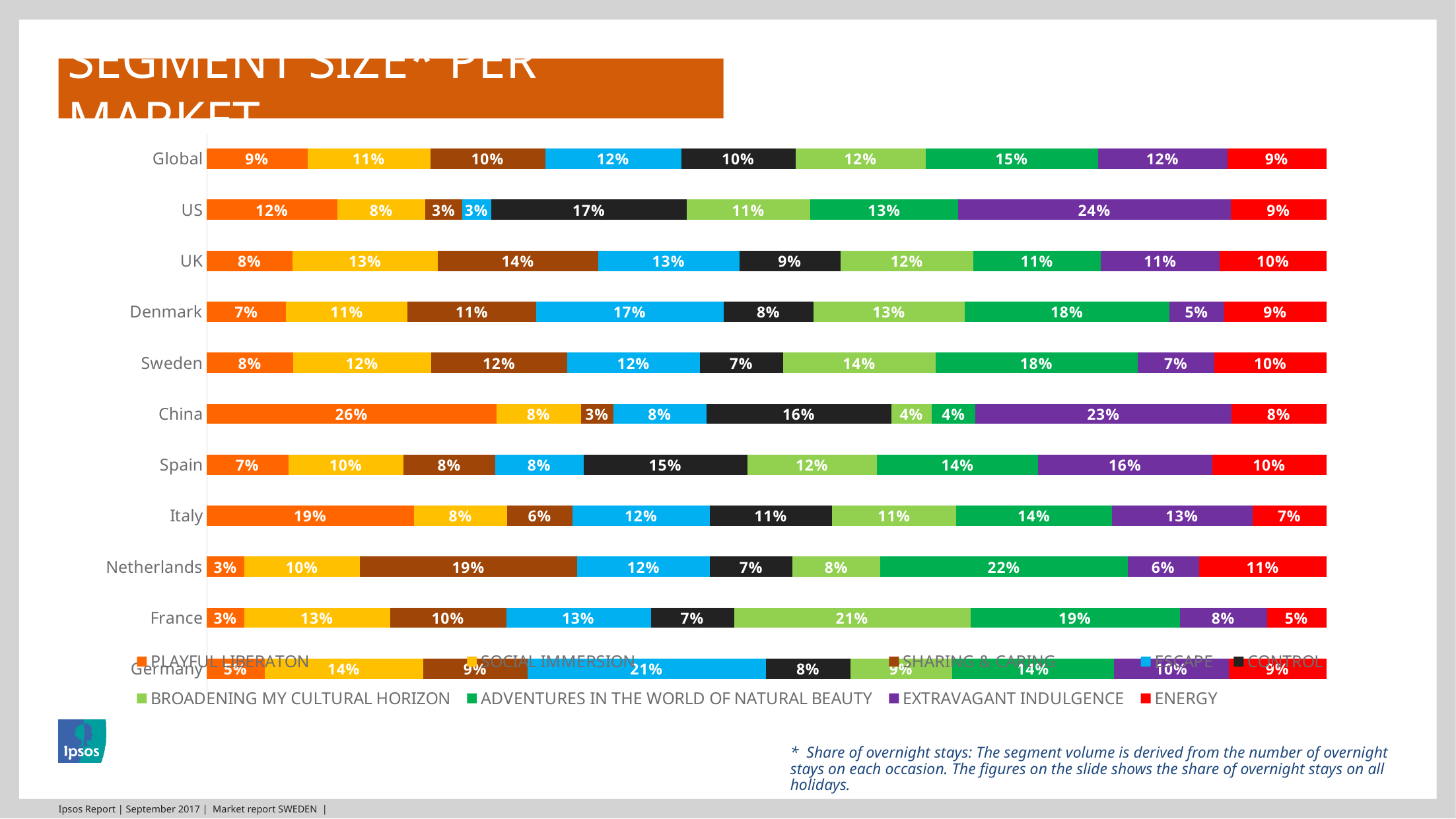
What is the Escape share for Germany? 21% How many markets (categories) are plotted on the chart? 11 How many series does the legend list? 9 Which market has the highest Adventures in the World of Natural Beauty share? Netherlands What kind of chart is shown on the slide? stacked bar chart What is the Extravagant Indulgence share for the US? 24% What is the Playful Liberaton share for China? 26% Which market has the lowest Energy share? France What is the difference between the Control share for the US and for Sweden? 10% What is the Broadening My Cultural Horizon share for France? 21% Which is larger, the Sharing & Caring share for the Netherlands or for the UK? Netherlands Which series is shown in purple in the legend? EXTRAVAGANT INDULGENCE